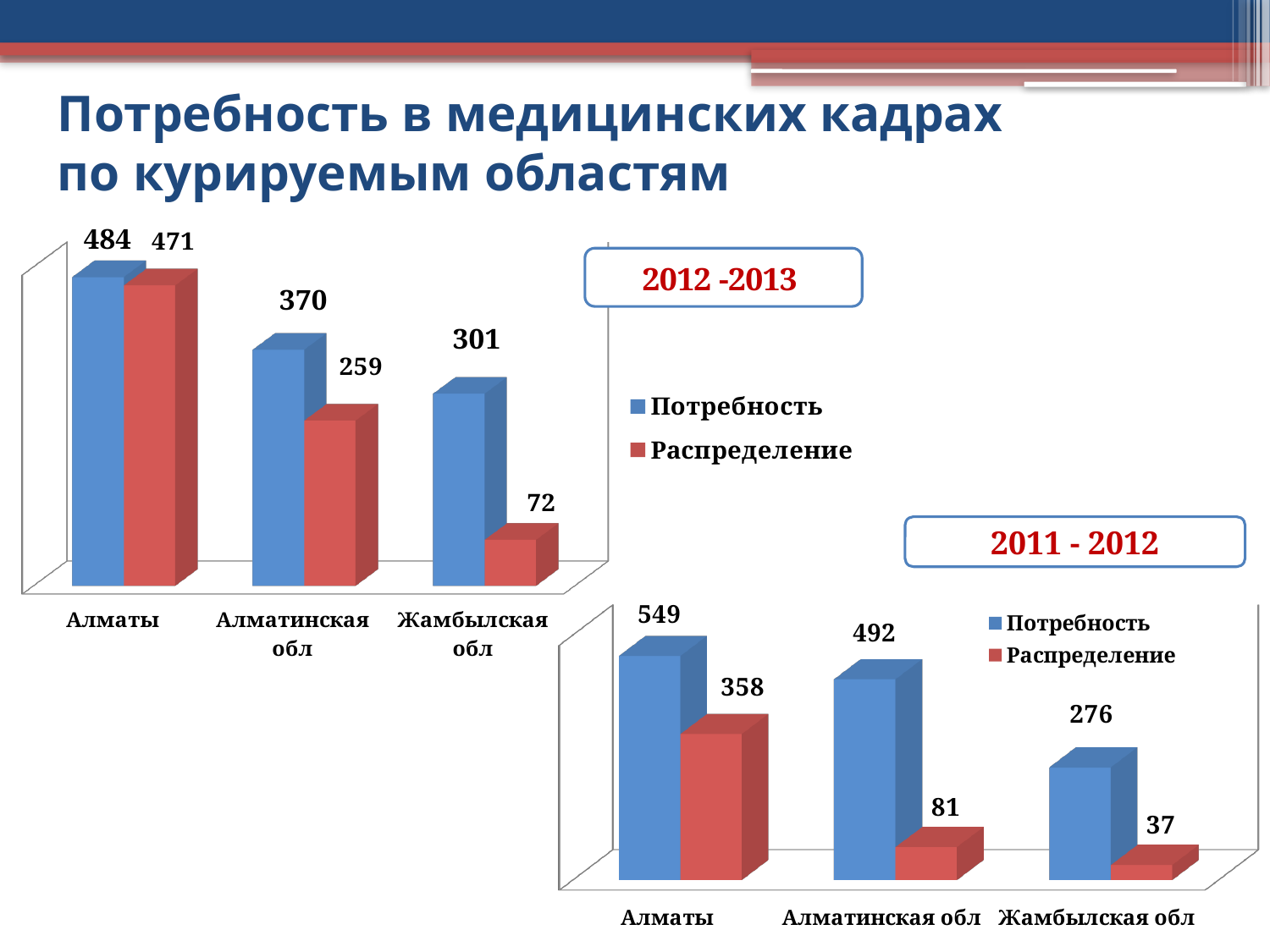
In the 2011-2012 chart, what is the Распределение value for Алматинская обл? 81 In the 2012-2013 chart, which category has the highest Потребность value? Алматы What type of chart is the 2012-2013 chart? Bar chart In the 2011-2012 chart, which category has the lowest Распределение value? Жамбылская обл In the 2012-2013 chart, what is the Распределение value for Жамбылская обл? 72 How many series does the legend of the 2011-2012 chart list? 2 In the 2012-2013 chart, what is the difference between Потребность and Распределение for Алматы? 13 In the 2011-2012 chart, what is the Потребность value for Алматы? 549 In the 2011-2012 chart, what is the difference between Потребность and Распределение for Жамбылская обл? 239 In the 2012-2013 chart, what is the Потребность value for Алматинская обл? 370 In the 2011-2012 chart, which is larger for Алматы: Потребность or Распределение? Потребность How many categories are shown on the x axis of the 2012-2013 chart? 3